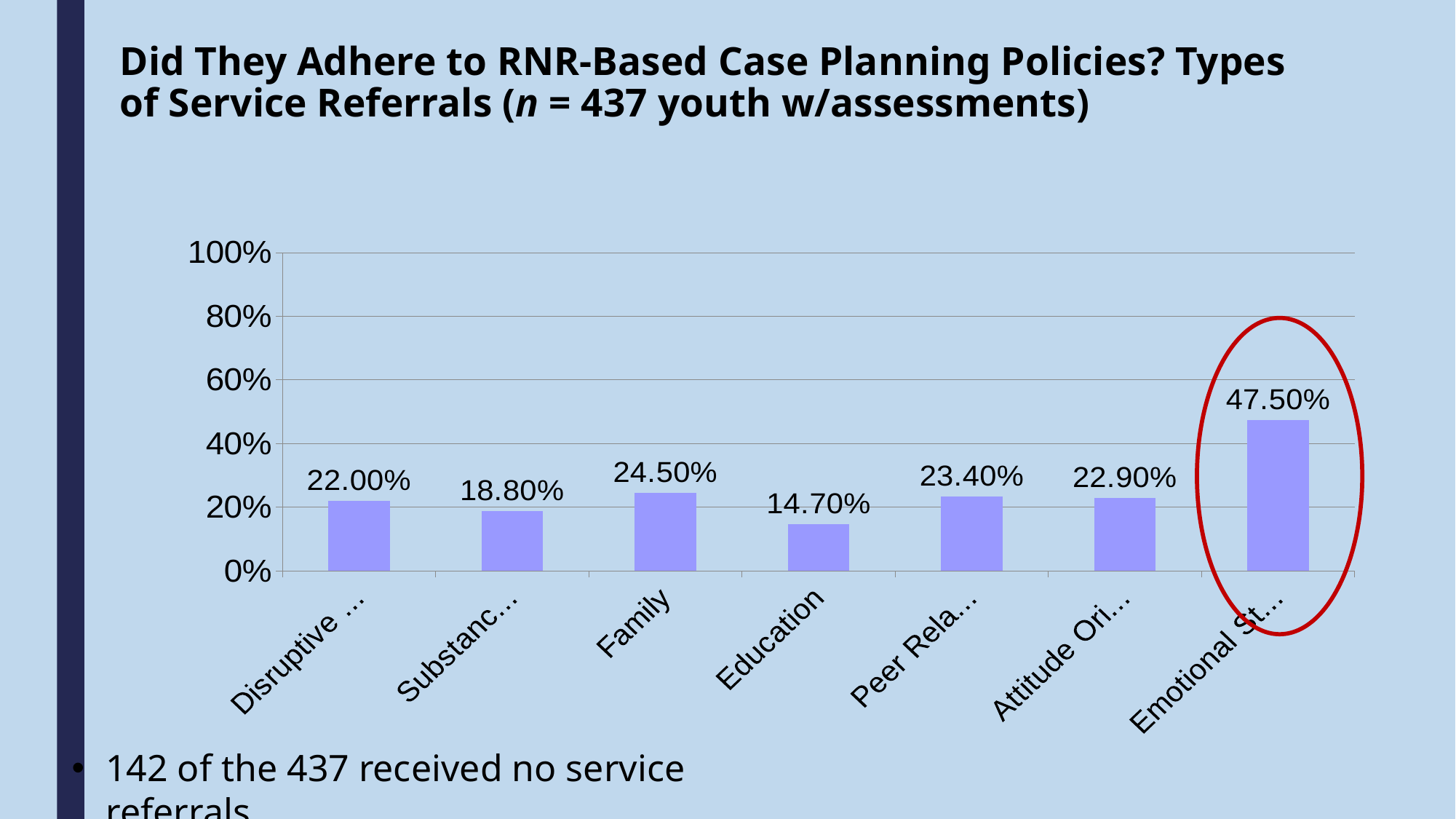
What is the value for Family? 24.50% Which bar is circled in red on the chart? Emotional St… What is the value for the category whose label begins "Substanc"? 18.80% Which category has the highest value? Emotional St… How many categories are shown in the chart? 7 Is the value for the category whose label begins "Emotional St" greater or less than 40%? greater What is the value for the category whose label begins "Emotional St"? 47.50% Which category has the lowest value? Education Which is larger, the value for Family or the value for Education? Family What is the difference between the value for Family and the value for Education? 9.80% What is the value for Education? 14.70% What kind of chart is shown on the slide? bar chart